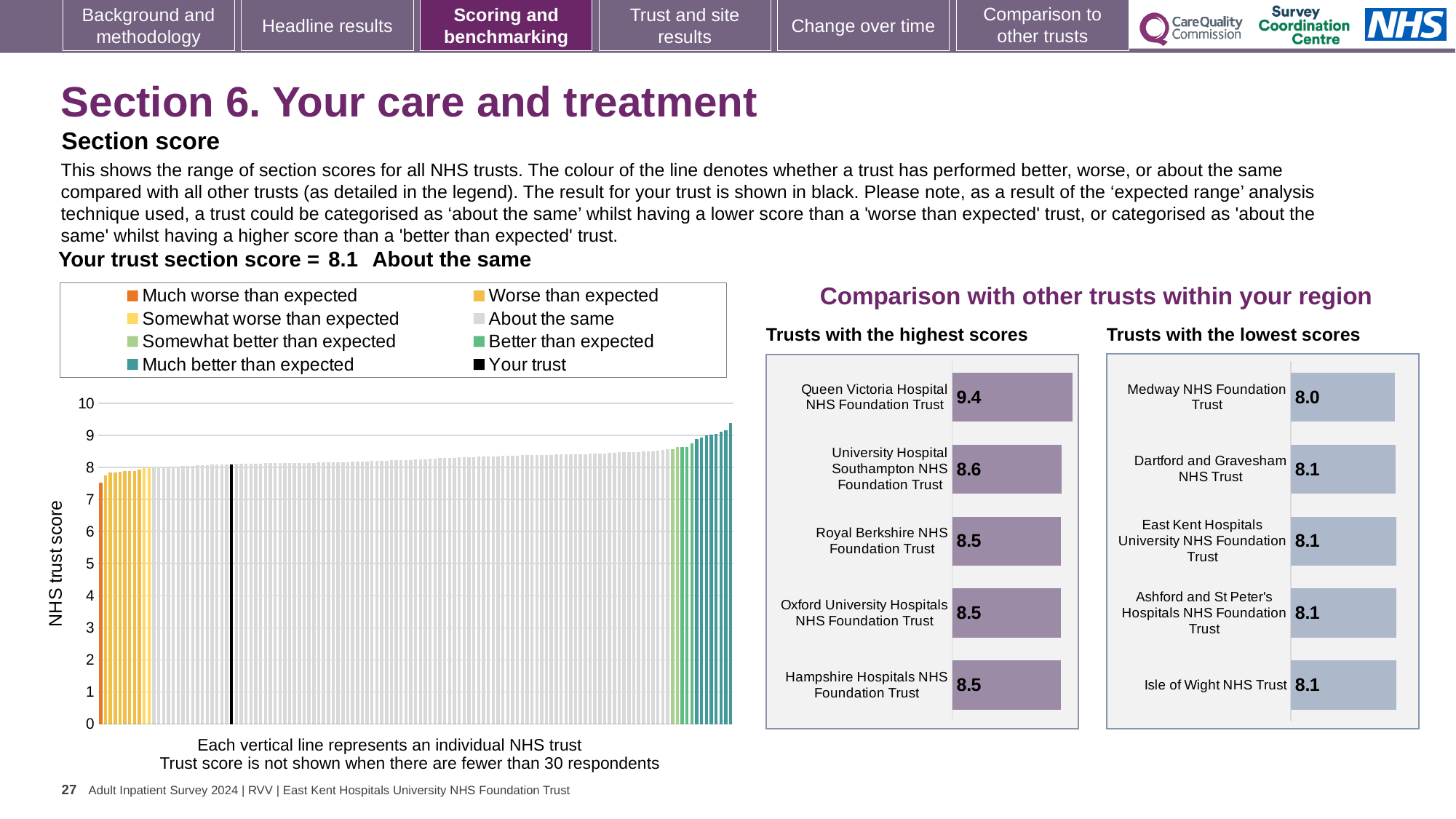
In the NHS trust score chart on the left, how many entries does the legend list? 8 In the 'Trusts with the lowest scores' chart, which trust has the lowest score? Medway NHS Foundation Trust In the 'Trusts with the highest scores' chart, what is the score for University Hospital Southampton NHS Foundation Trust? 8.6 In the 'Trusts with the highest scores' chart, which has a higher score: Queen Victoria Hospital NHS Foundation Trust or Royal Berkshire NHS Foundation Trust? Queen Victoria Hospital NHS Foundation Trust In the 'Trusts with the highest scores' chart, what is the score for Queen Victoria Hospital NHS Foundation Trust? 9.4 In the 'Trusts with the highest scores' chart, what is the difference between the scores of Queen Victoria Hospital NHS Foundation Trust and University Hospital Southampton NHS Foundation Trust? 0.8 In the NHS trust score chart on the left, do the values rise or fall from left to right along the x axis? rise In the 'Trusts with the highest scores' chart, how many trusts are shown? 5 In the 'Trusts with the lowest scores' chart, what is the score for Medway NHS Foundation Trust? 8.0 In the 'Trusts with the lowest scores' chart, what is the score for East Kent Hospitals University NHS Foundation Trust? 8.1 In the 'Trusts with the highest scores' chart, which trust has the highest score? Queen Victoria Hospital NHS Foundation Trust In the 'Trusts with the lowest scores' chart, what is the difference between the scores of Dartford and Gravesham NHS Trust and Medway NHS Foundation Trust? 0.1